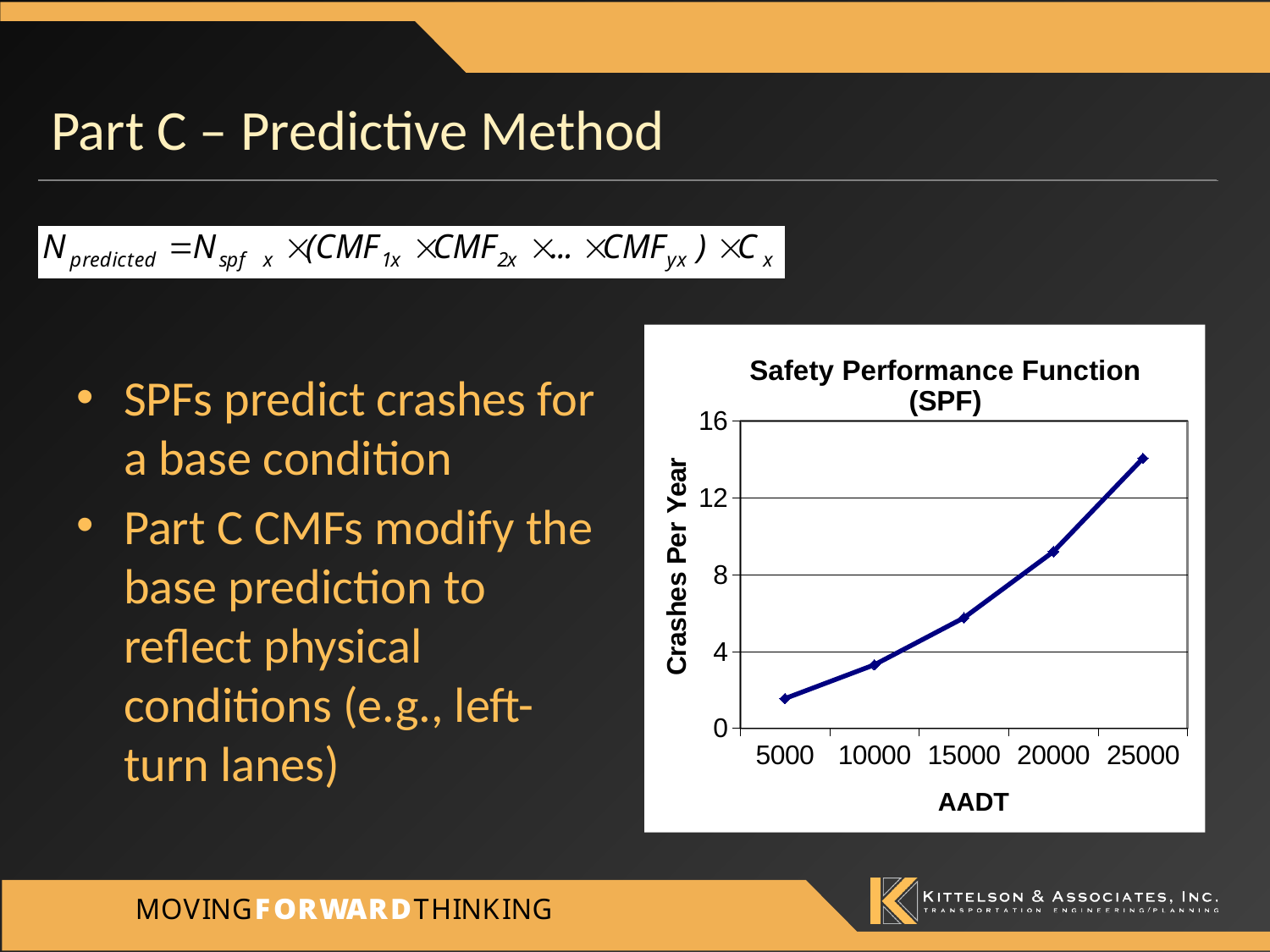
What type of chart is shown on the slide? line chart At which AADT value is the number of crashes per year highest? 25000 Is the value for AADT 15000 greater or less than 8? less Is the value for AADT 20000 greater or less than 8? greater At which AADT value is the number of crashes per year lowest? 5000 Is the value for AADT 25000 greater or less than 12? greater How many data points are plotted on the line? 5 Do crashes per year rise or fall as AADT increases along the x axis? rise Which has more crashes per year, AADT 10000 or AADT 20000? AADT 20000 What is the title of the chart? Safety Performance Function (SPF) What is the label of the y-axis of the chart? Crashes Per Year